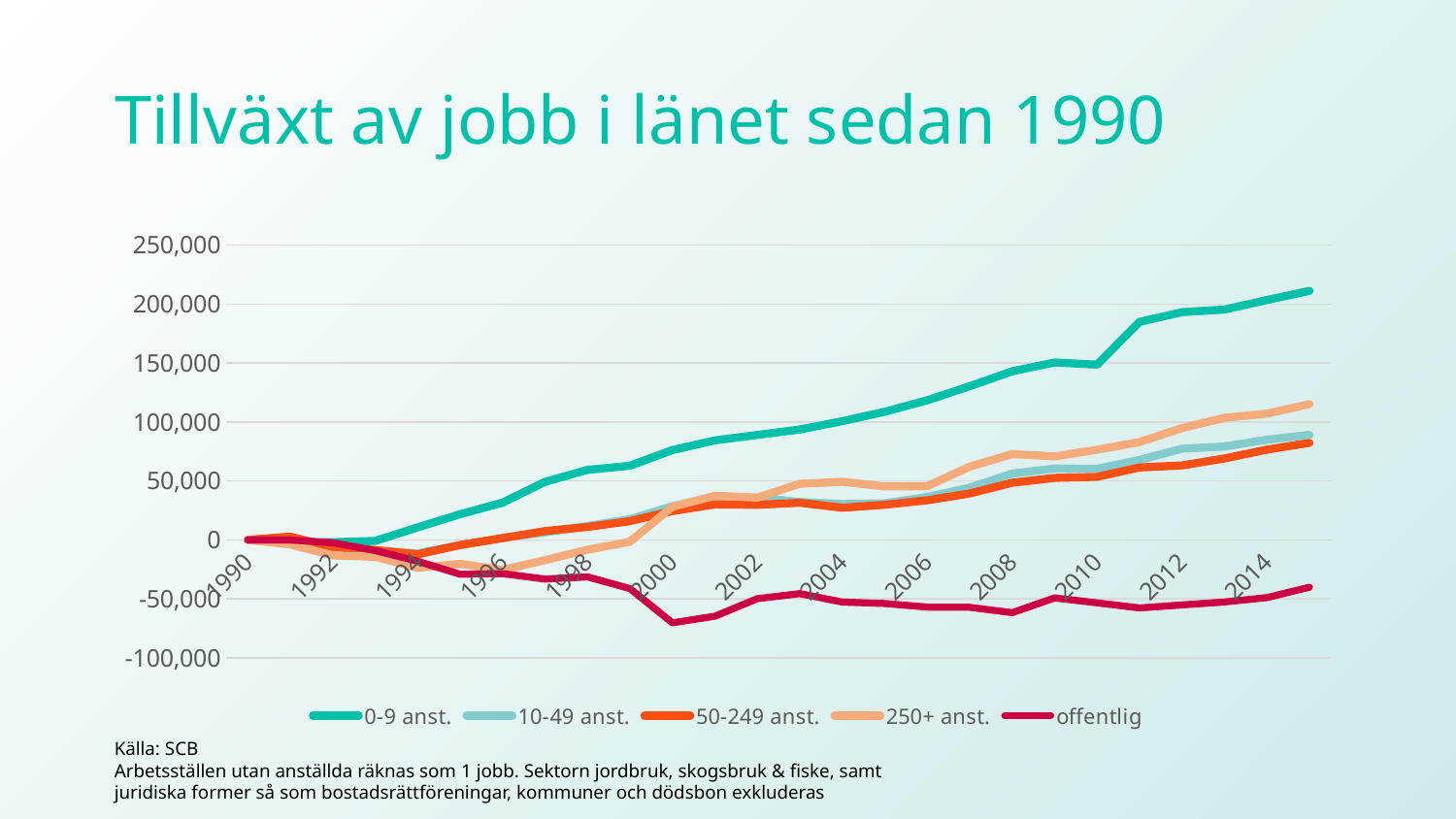
What kind of chart is shown on the slide? line chart Which series has the highest value at the right end of the chart (2014)? 0-9 anst. Does the 0-9 anst. series rise or fall between 1994 and 2014? rises Which series has the lowest value at the right end of the chart (2014)? offentlig Does the offentlig series rise or fall between 1990 and 2000? falls Is the value for offentlig in 2000 greater or less than -50,000? less Is the value for 250+ anst. in 2014 greater or less than 100,000? greater In 2014, which is higher: 250+ anst. or 50-249 anst.? 250+ anst. How many series does the legend list? 5 What source is cited below the chart? Källa: SCB Is the value for 0-9 anst. in 2010 greater or less than 100,000? greater What is the title of the chart? Tillväxt av jobb i länet sedan 1990